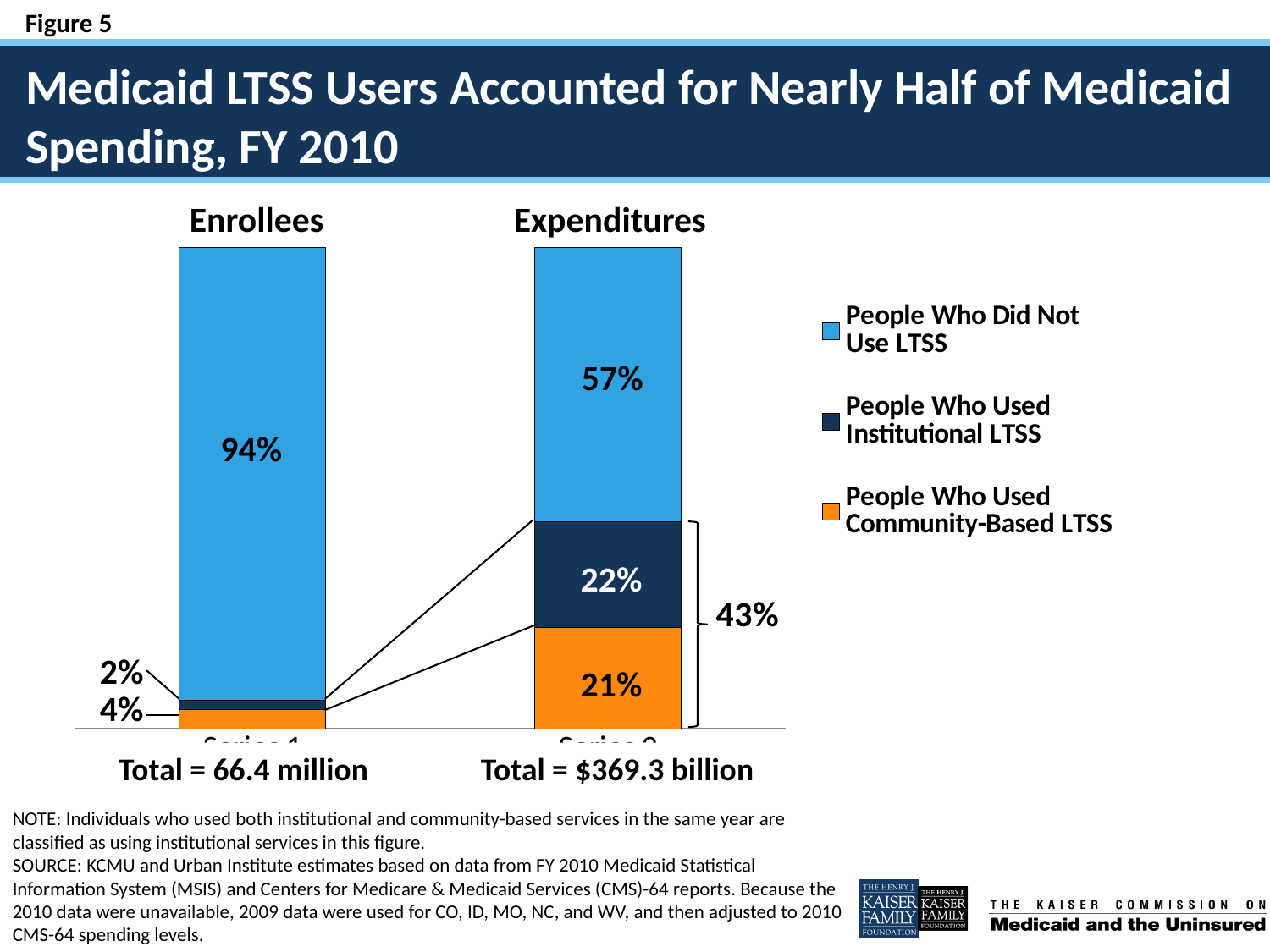
What is the difference between the share of Expenditures for people who did not use LTSS and the share of Enrollees who did not use LTSS? 37 percentage points What share of Enrollees used institutional LTSS? 2% What share of Expenditures went to people who used community-based LTSS? 21% What share of Expenditures went to people who used institutional LTSS? 22% What share of Expenditures went to people who did not use LTSS? 57% How many series does the legend list? 3 What share of Enrollees used community-based LTSS? 4% What total is shown beneath the Expenditures bar? $369.3 billion What kind of chart is shown on the slide? Stacked bar chart What combined share of Expenditures is marked by the bracket for LTSS users? 43% What share of Enrollees did not use LTSS? 94% Which bar has the larger share for people who used institutional LTSS, Enrollees or Expenditures? Expenditures